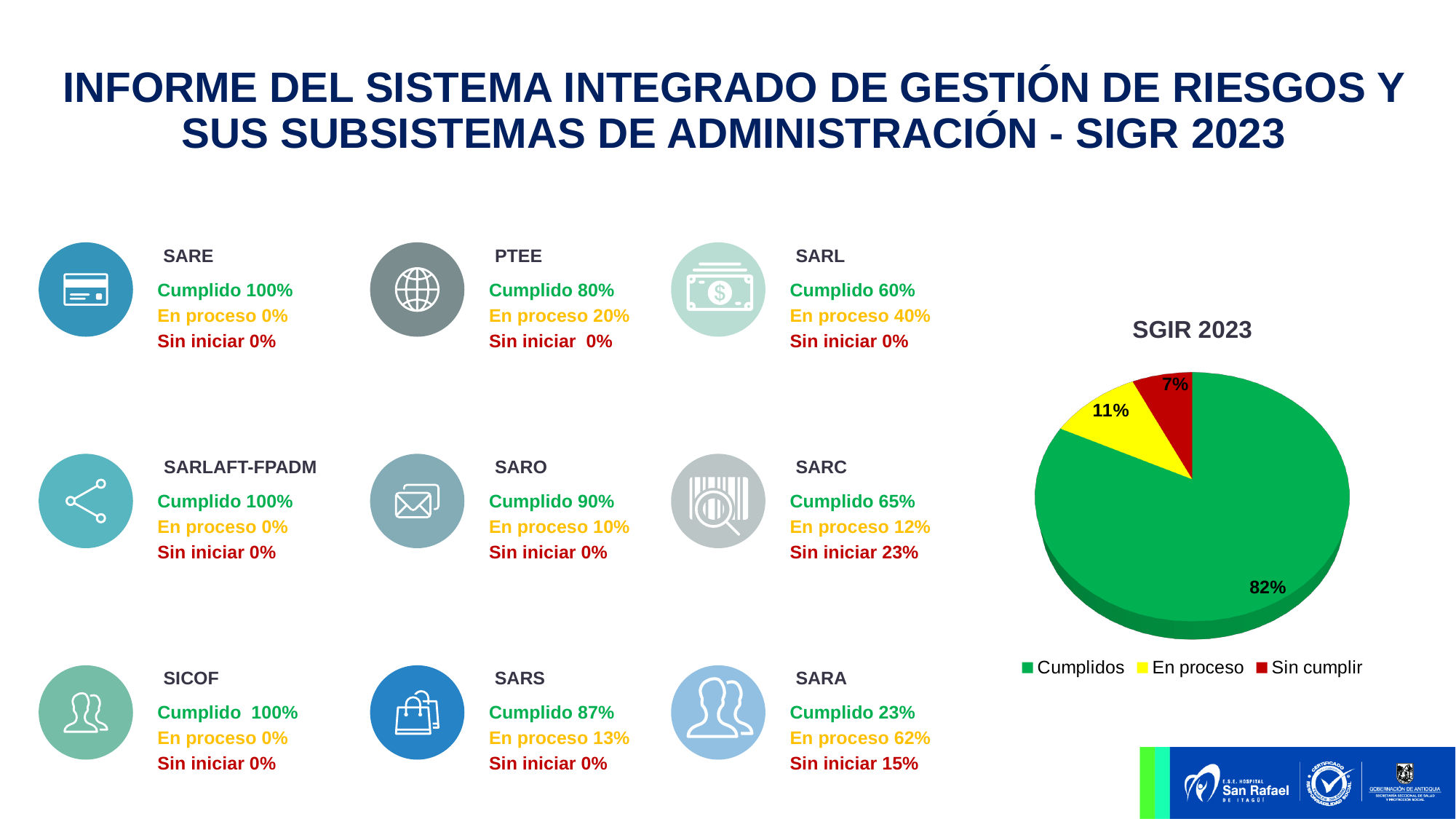
Which category has the smallest slice in the SGIR 2023 pie chart? Sin cumplir How many entries does the legend of the SGIR 2023 pie chart list? 3 What is the value of the Cumplidos slice in the SGIR 2023 pie chart? 82% What kind of chart is shown under the title SGIR 2023? pie chart What is the value of the Sin cumplir slice in the SGIR 2023 pie chart? 7% How many slices does the SGIR 2023 pie chart have? 3 What is the value of the En proceso slice in the SGIR 2023 pie chart? 11% In the SGIR 2023 pie chart, what is the difference between the En proceso and Sin cumplir slices? 4% Which category has the largest slice in the SGIR 2023 pie chart? Cumplidos In the SGIR 2023 pie chart, which is larger: En proceso or Sin cumplir? En proceso What colour is the Sin cumplir slice in the SGIR 2023 pie chart? red In the SGIR 2023 pie chart, what is the difference between the Cumplidos and En proceso slices? 71%